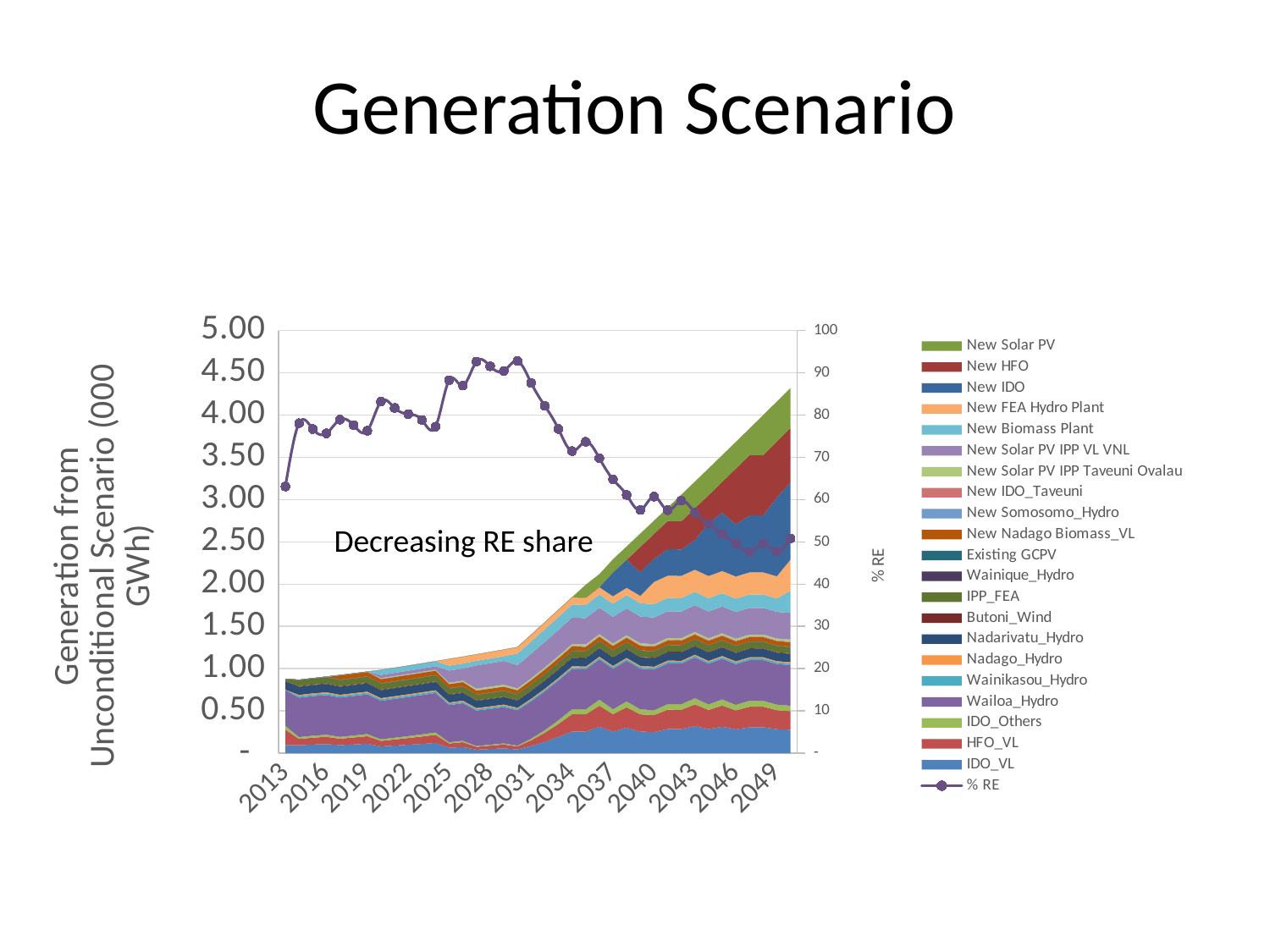
How many series does the legend list? 22 What is the title of the left vertical axis? Generation from Unconditional Scenario (000 GWh) Which series is plotted as a line with markers rather than as an area? % RE How many year labels are shown on the x axis? 13 What kind of chart is shown on the slide? Stacked area chart with a line Is the total generation in 2031 greater or less than 2.00? less Is the % RE value in 2049 greater or less than 60? less Does the % RE line rise or fall between 2031 and 2046? Falls Is the total generation in 2049 greater or less than 4.00? greater Does total generation rise or fall from 2013 to 2049? Rises